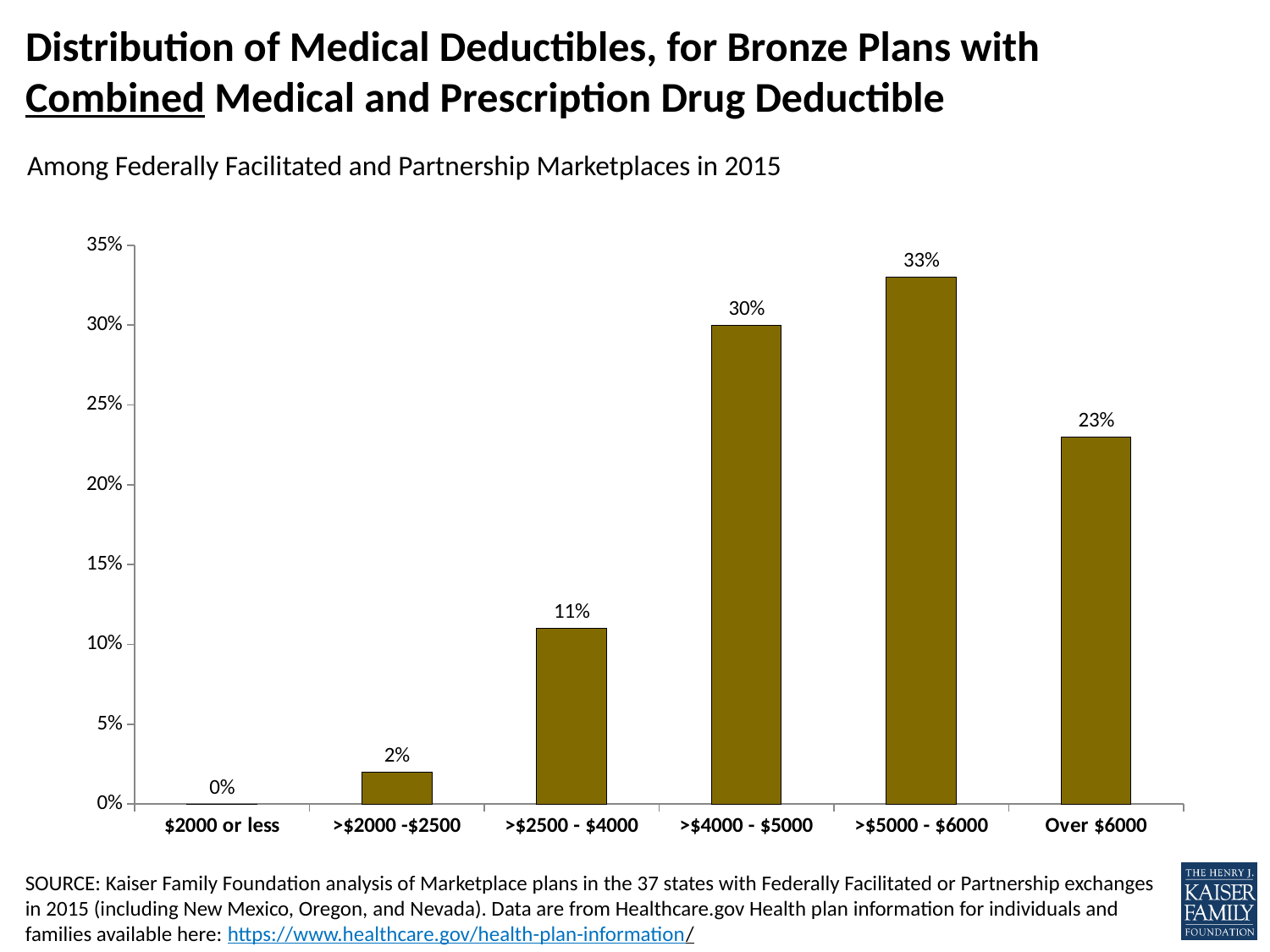
What is the highest value shown on the vertical axis? 35% What type of chart is shown on the slide? Bar chart Which category has a larger share: >$4000 - $5000 or Over $6000? >$4000 - $5000 Which deductible category has the lowest percentage of plans? $2000 or less What percentage of bronze plans have a combined deductible of >$5000 - $6000? 33% What is the value shown for the >$2500 - $4000 category? 11% Which deductible category has the highest percentage of plans? >$5000 - $6000 What is the difference in percentage points between the >$5000 - $6000 and >$4000 - $5000 categories? 3 percentage points How many deductible categories are shown on the x axis? 6 What percentage of plans fall in the Over $6000 category? 23% What is the combined percentage of plans in the >$2000 -$2500 and >$2500 - $4000 categories? 13% What is the value for the $2000 or less category? 0%